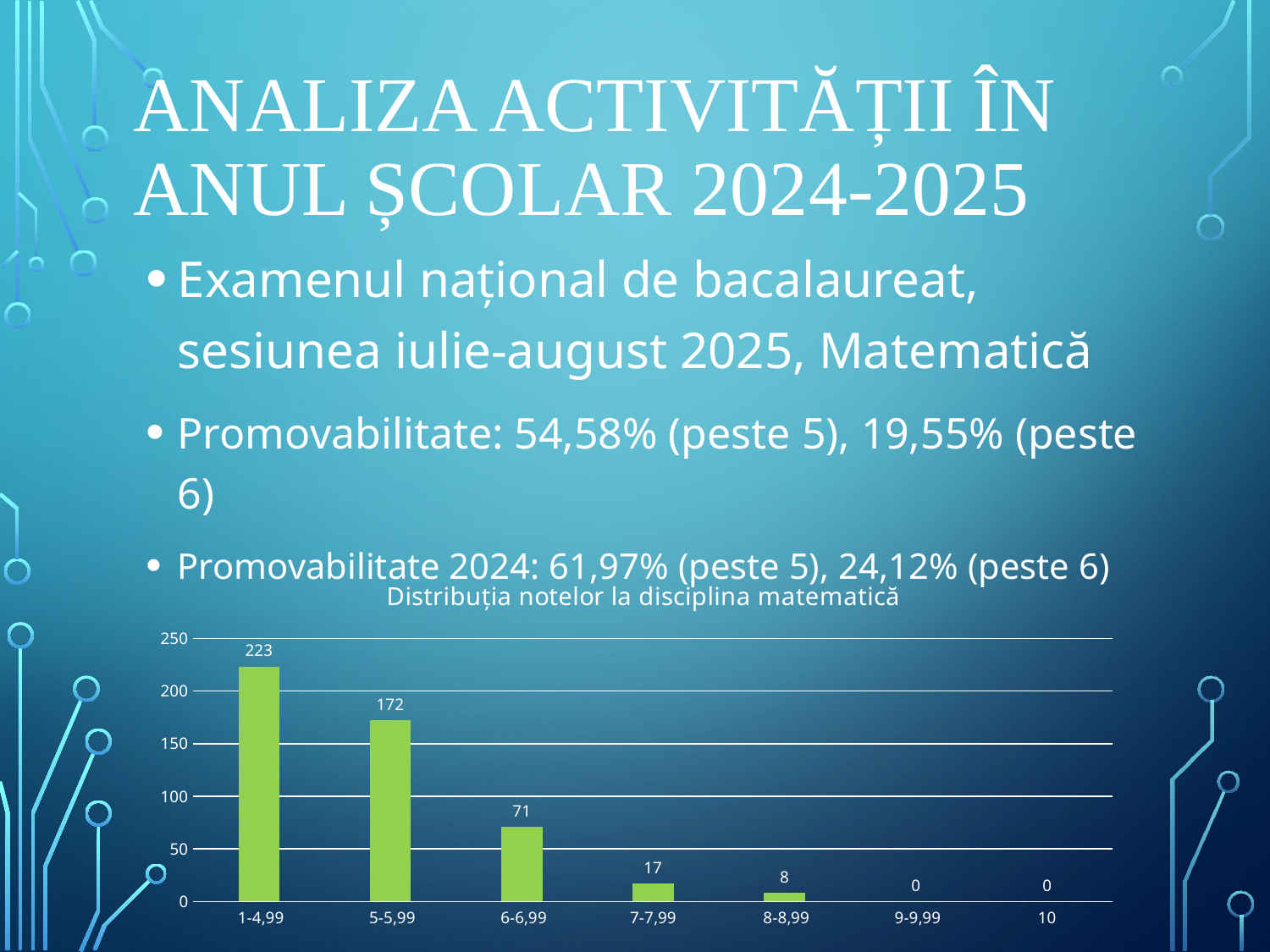
What is the difference between the values for 6-6,99 and 7-7,99? 54 What is the title of the chart? Distribuția notelor la disciplina matematică What is the value for the 6-6,99 category? 71 What is the difference between the values for 1-4,99 and 5-5,99? 51 Do the values rise or fall from left to right along the x axis? fall What kind of chart is shown on the slide? bar chart What is the value for the 8-8,99 category? 8 Which category has the highest value? 1-4,99 What is the value for the 1-4,99 category? 223 Is the value for 5-5,99 greater or less than 150? greater How many categories are shown on the x axis? 7 Which is larger, the value for 5-5,99 or the value for 6-6,99? 5-5,99